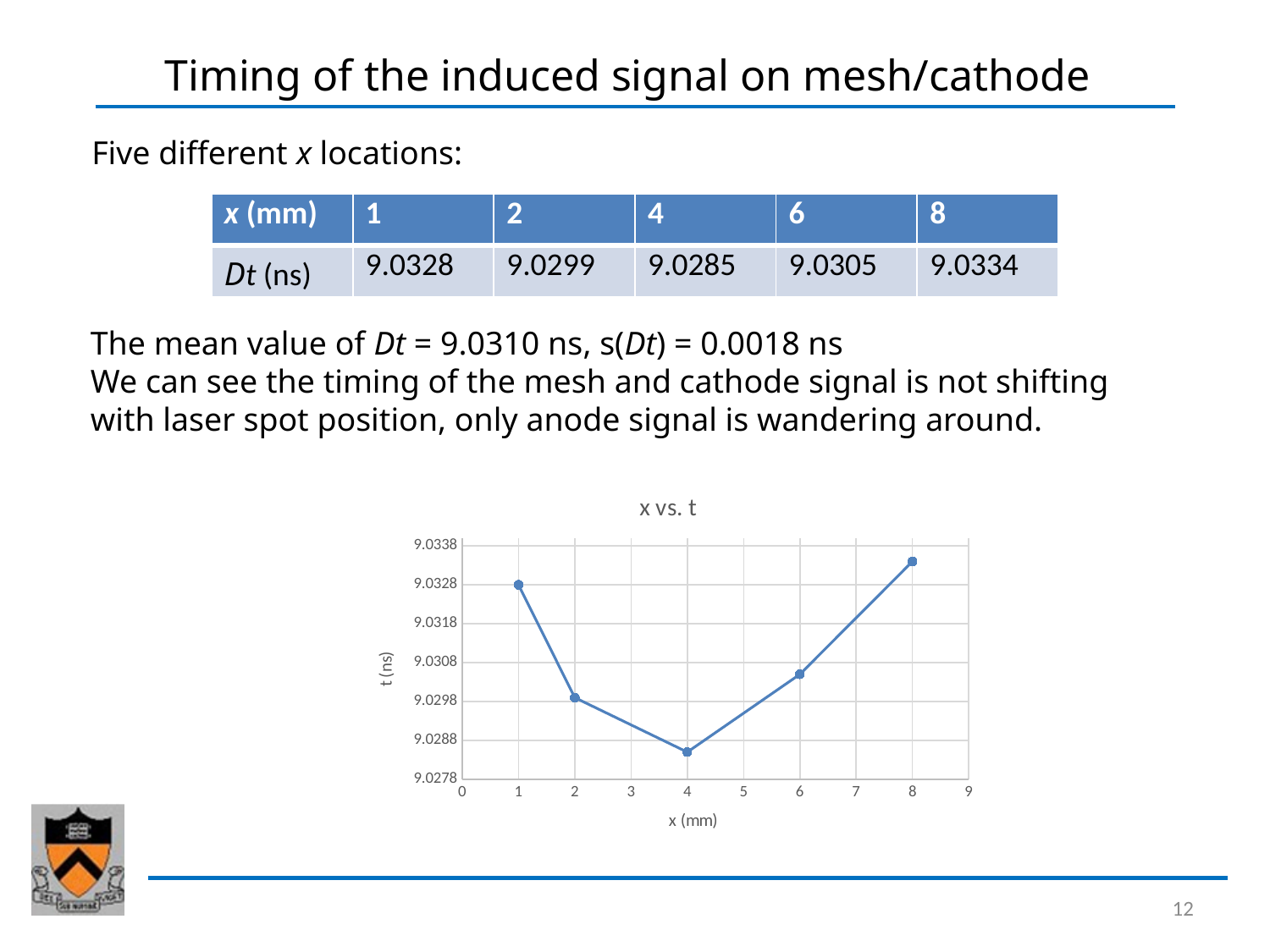
In the "x vs. t" chart, is the value at x = 4 mm greater or less than 9.0288? less What is the title of the chart on the slide? x vs. t What is the value of Dt (ns) at x = 8 mm? 9.0334 How many data points are plotted in the "x vs. t" chart? 5 What kind of chart is shown on the slide? line chart What is the value of Dt (ns) at x = 4 mm? 9.0285 What is the difference between Dt at x = 8 mm and Dt at x = 4 mm, in ns? 0.0049 At which x (mm) value is the plotted t highest in the "x vs. t" chart? 8 Which has the larger plotted t value in the "x vs. t" chart: x = 2 mm or x = 6 mm? 6 In the "x vs. t" chart, is the value at x = 1 mm greater or less than 9.0318? greater At which x (mm) value is the plotted t lowest in the "x vs. t" chart? 4 Do the plotted values rise or fall as x goes from 1 mm to 4 mm in the "x vs. t" chart? fall